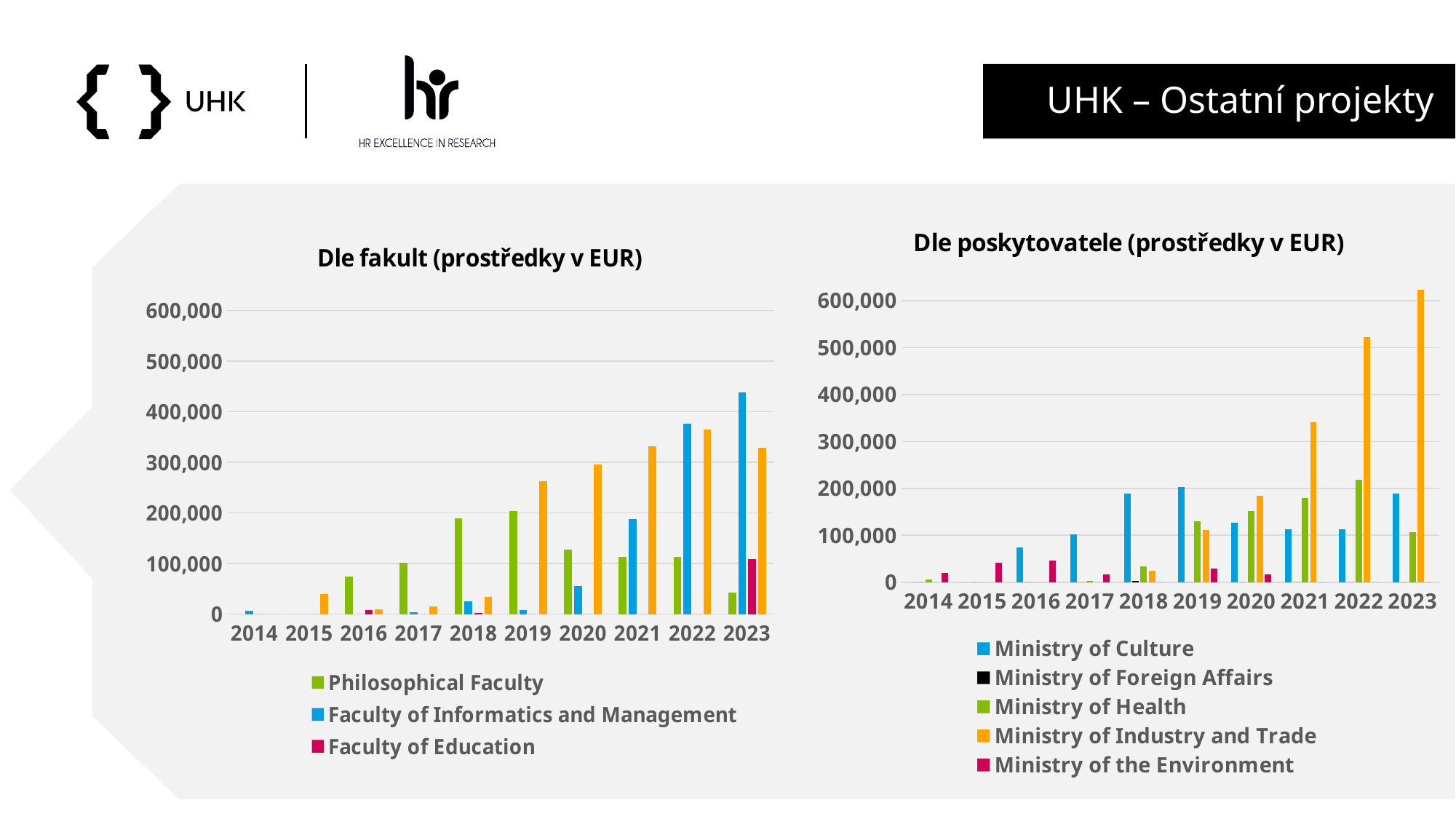
In the right chart "Dle poskytovatele (prostředky v EUR)", which year has the tallest bar for Ministry of Industry and Trade? 2023 In the right chart "Dle poskytovatele (prostředky v EUR)", is the value for Ministry of Industry and Trade in 2023 greater or less than 500,000? greater How many series does the legend of the right chart "Dle poskytovatele (prostředky v EUR)" list? 5 In the left chart "Dle fakult (prostředky v EUR)", which is larger in 2018: Philosophical Faculty or Faculty of Informatics and Management? Philosophical Faculty In the right chart "Dle poskytovatele (prostředky v EUR)", which is larger in 2019: Ministry of Culture or Ministry of Health? Ministry of Culture In the right chart "Dle poskytovatele (prostředky v EUR)", do the values for Ministry of Industry and Trade rise or fall from 2019 to 2023? rise How many years are shown on the x axis of the right chart "Dle poskytovatele (prostředky v EUR)"? 10 In the left chart "Dle fakult (prostředky v EUR)", is the value for Faculty of Informatics and Management in 2022 greater or less than 400,000? less What kind of chart is the left chart titled "Dle fakult (prostředky v EUR)"? bar chart In the left chart "Dle fakult (prostředky v EUR)", is the value for Faculty of Informatics and Management in 2023 greater or less than 400,000? greater In the left chart "Dle fakult (prostředky v EUR)", which faculty has the tallest bar in 2023? Faculty of Informatics and Management How many series does the legend of the left chart "Dle fakult (prostředky v EUR)" list? 3